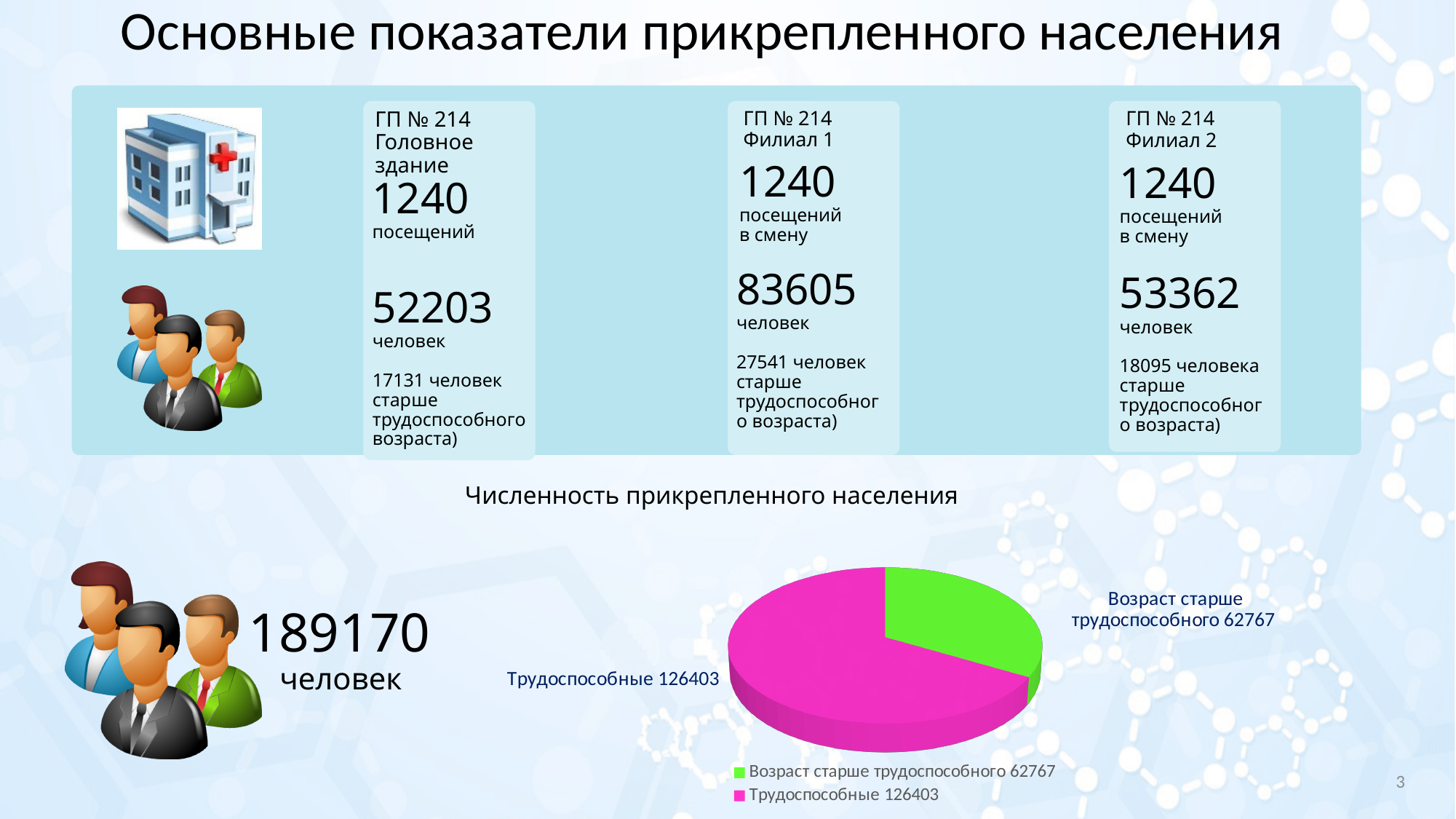
In the pie chart, what is the value for "Возраст старше трудоспособного"? 62767 How many entries does the pie chart's legend list? 2 Which slice of the pie chart is the largest? Трудоспособные In the pie chart, what is the value for "Трудоспособные"? 126403 Which slice of the pie chart is the smallest? Возраст старше трудоспособного What kind of chart is shown under the heading "Численность прикрепленного населения"? pie chart What is the difference between the "Трудоспособные" and "Возраст старше трудоспособного" values in the pie chart? 63636 What is the total of the two slices in the pie chart? 189170 What colour is the "Трудоспособные" slice in the pie chart? magenta (pink) In the pie chart, which is larger: "Трудоспособные" or "Возраст старше трудоспособного"? Трудоспособные What is the title shown above the pie chart? Численность прикрепленного населения How many slices does the pie chart have? 2